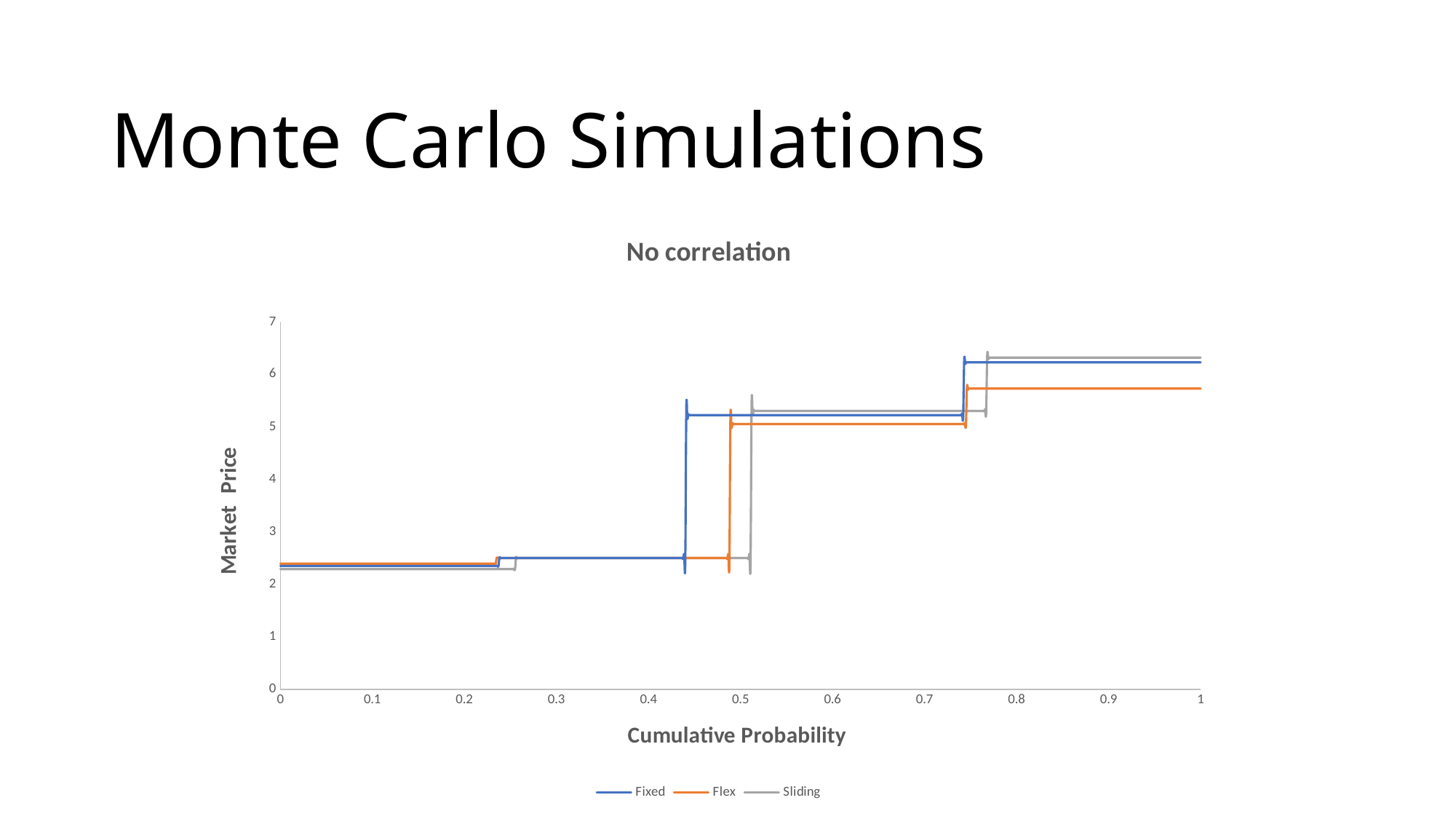
Do the plotted values rise or fall as cumulative probability increases from 0 to 1? rise What is the label of the vertical axis? Market Price Is the value of the Flex series at a cumulative probability of 0.9 greater or less than 6? less At a cumulative probability of 0.6, which series has the higher market price, Sliding or Flex? Sliding How many series does the legend list? 3 Is the value of the Fixed series at a cumulative probability of 0.9 greater or less than 6? greater Which series has the lowest market price at a cumulative probability of 1? Flex Is the value of the Fixed series at a cumulative probability of 0.3 greater or less than 3? less What is the title of the chart? No correlation What kind of chart is shown on the slide? line chart At a cumulative probability of 0.9, which series has the higher market price, Fixed or Flex? Fixed